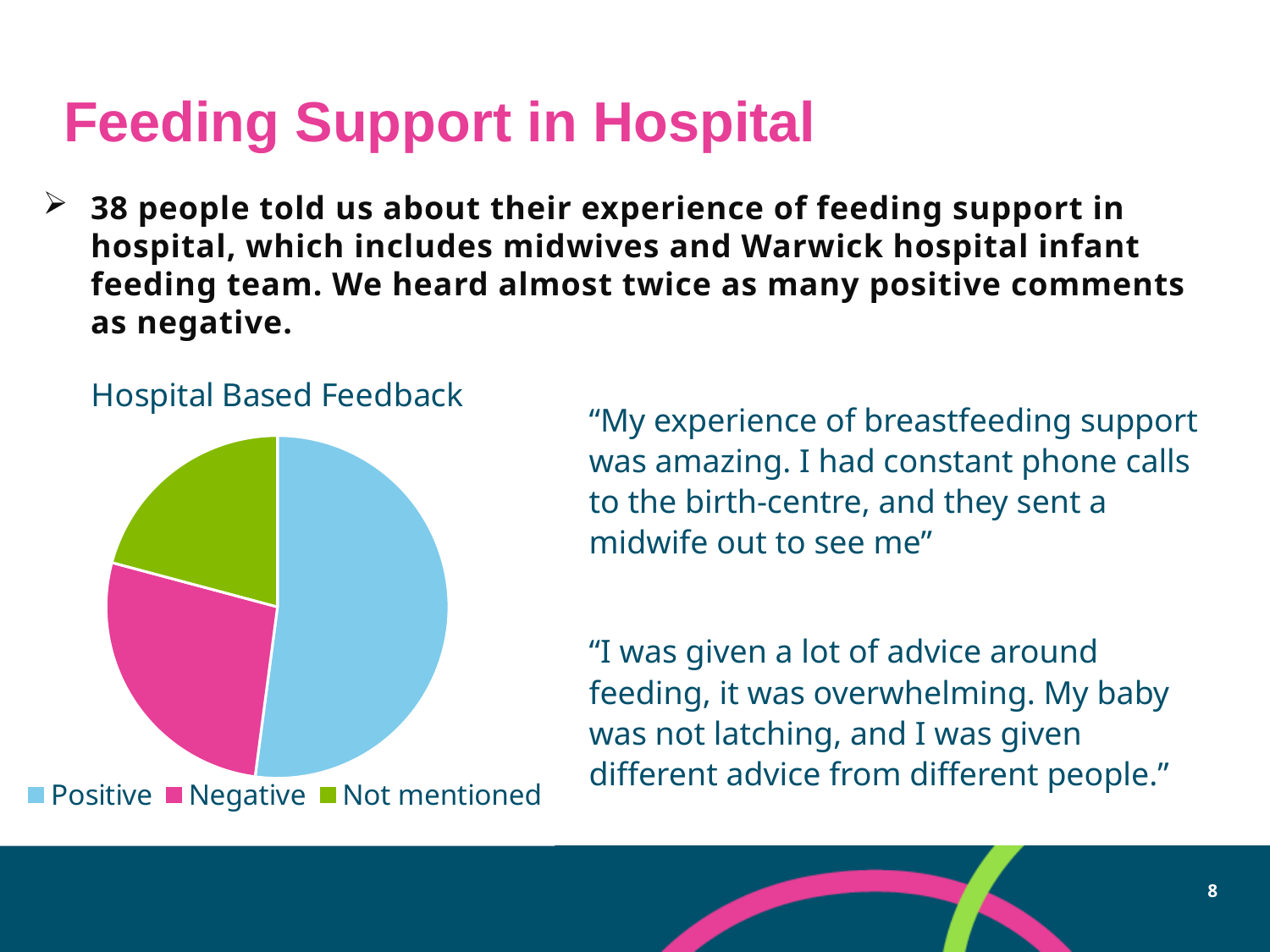
Which category has the largest slice of the pie chart? Positive What is the title of the chart on the slide? Hospital Based Feedback Which colour represents the Negative category in the pie chart? Pink Which slice is larger, Positive or Negative? Positive What kind of chart is shown on the slide? Pie chart Which category is shown in green in the pie chart? Not mentioned Which slice is larger, Negative or Not mentioned? Negative How many slices does the pie chart have? 3 How many entries does the chart's legend list? 3 Which category has the smallest slice of the pie chart? Not mentioned